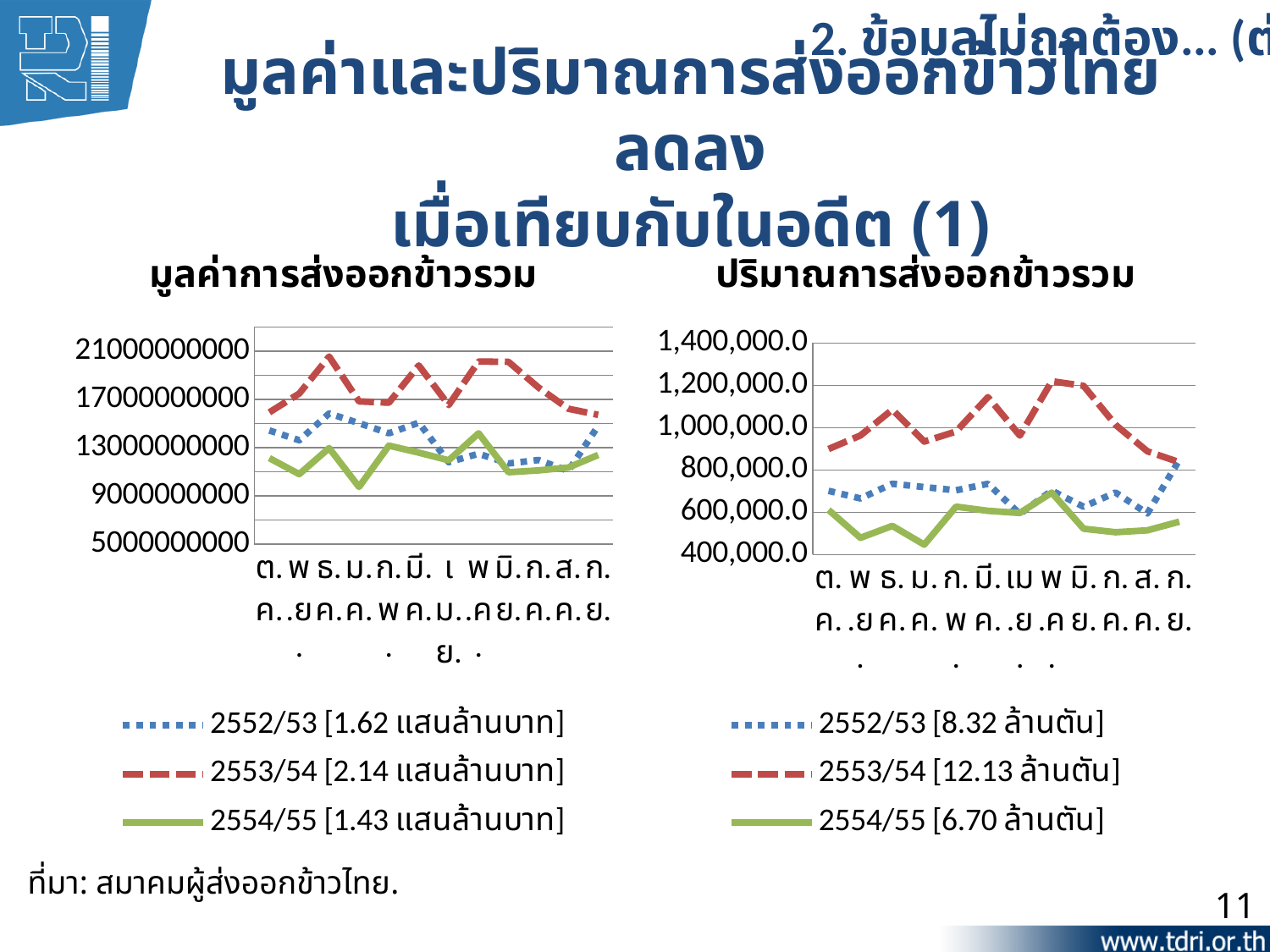
How many series does the legend of the right chart (ปริมาณการส่งออกข้าวรวม) list? 3 In the right chart (ปริมาณการส่งออกข้าวรวม), what is the difference between the legend totals of 2553/54 and 2554/55? 5.43 ล้านตัน In the right chart (ปริมาณการส่งออกข้าวรวม), which series has the largest total according to the legend? 2553/54 In the right chart (ปริมาณการส่งออกข้าวรวม), is the value for 2554/55 in ม.ค. greater or less than 600,000.0? less In the left chart (มูลค่าการส่งออกข้าวรวม), is the value for 2554/55 in ม.ค. greater or less than 13000000000? less How many months are shown on the x axis of the right chart (ปริมาณการส่งออกข้าวรวม)? 12 What kind of chart is the left chart titled มูลค่าการส่งออกข้าวรวม? line chart In the right chart (ปริมาณการส่งออกข้าวรวม), what total is shown in the legend for the 2554/55 series? 6.70 ล้านตัน In the left chart (มูลค่าการส่งออกข้าวรวม), what total is shown in the legend for the 2553/54 series? 2.14 แสนล้านบาท In the right chart (ปริมาณการส่งออกข้าวรวม), which series has the larger value in ต.ค., 2553/54 or 2554/55? 2553/54 In the left chart (มูลค่าการส่งออกข้าวรวม), which series has the larger value in ธ.ค., 2553/54 or 2552/53? 2553/54